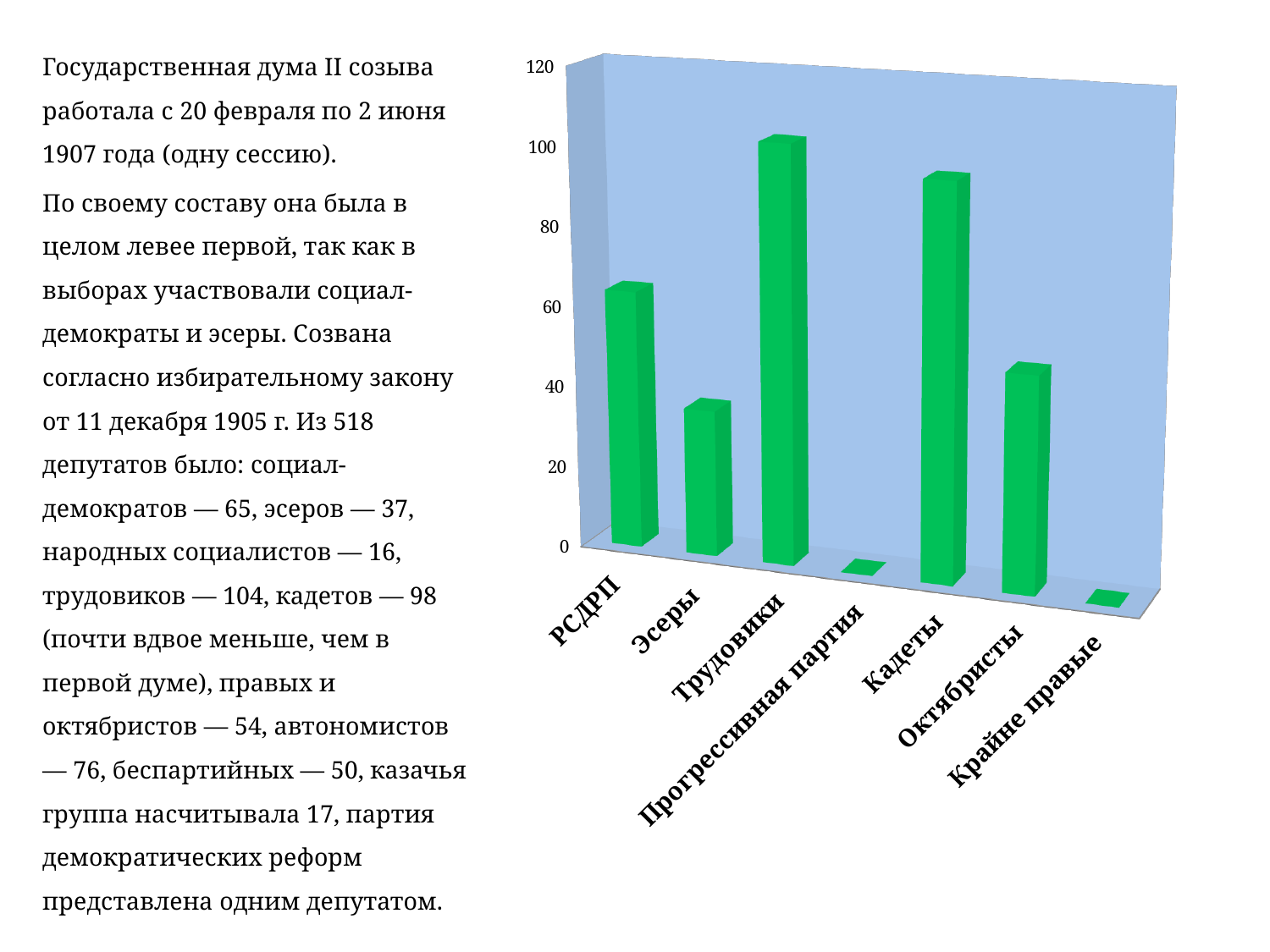
How many categories (parties) are shown on the x axis of the chart? 7 Is the value for Крайне правые greater or less than 20? less Which is larger, the value for РСДРП or the value for Эсеры? РСДРП What kind of chart is shown on the slide? bar chart Is the value for РСДРП greater or less than 40? greater Is the value for Октябристы greater or less than 60? less Which is larger, the value for Кадеты or the value for Октябристы? Кадеты Which category has the highest bar in the chart? Трудовики